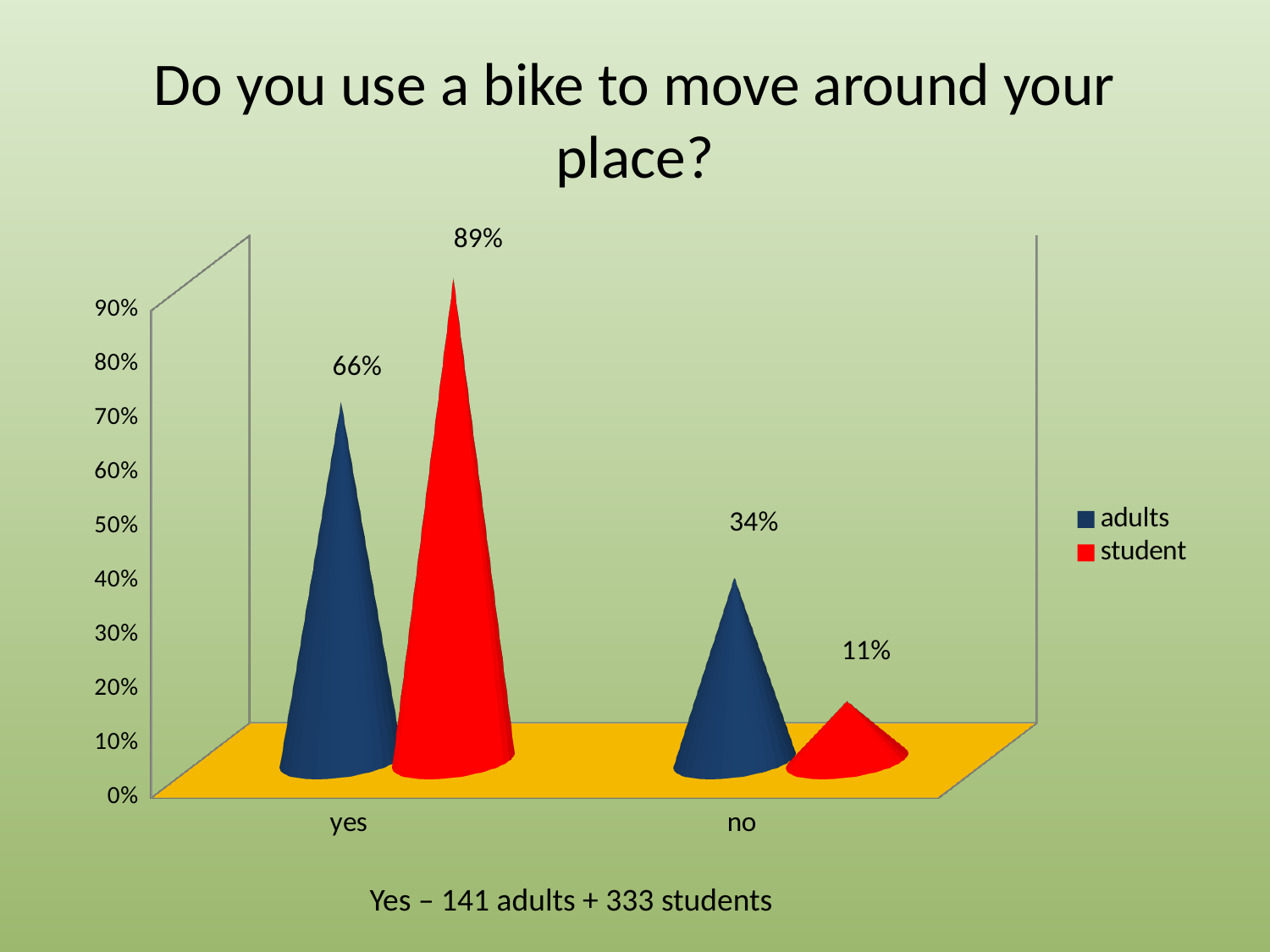
Which group has the higher value for "yes", adults or students? students What percentage of students answered "yes"? 89% What percentage of adults answered "yes"? 66% What percentage of students answered "no"? 11% What is the difference between the student and adult values for "yes"? 23% Which colour represents the student series? red What is the difference between the adult and student values for "no"? 23% What is the title of the chart? Do you use a bike to move around your place? What percentage of adults answered "no"? 34% Which group has the lower value for "no"? student How many categories are shown on the x axis? 2 How many series does the legend list? 2